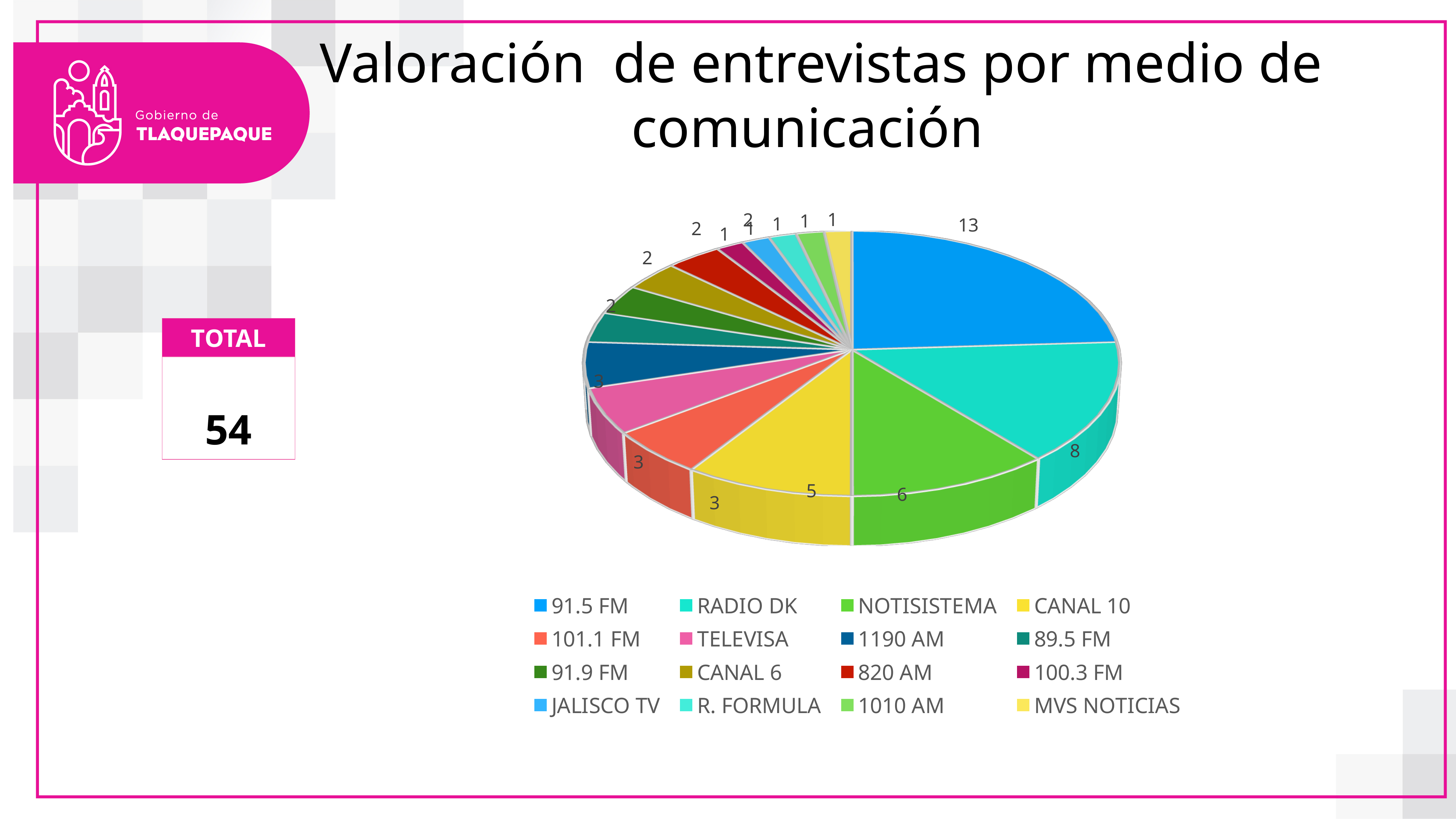
What is the value shown for 91.5 FM? 13 What is the value shown for RADIO DK? 8 How many media (categories) are listed in the pie chart legend? 16 What is the value shown for TELEVISA? 3 What is the value shown for CANAL 10? 5 What total number of interviews is shown in the TOTAL box on the slide? 54 What is the difference between the values for 91.5 FM and RADIO DK? 5 Which has a larger value, NOTISISTEMA or CANAL 10? NOTISISTEMA What is the difference between the values for 91.5 FM and NOTISISTEMA? 7 What kind of chart is shown on the slide? pie chart Which medium has the largest slice in the pie chart? 91.5 FM What is the value shown for NOTISISTEMA? 6